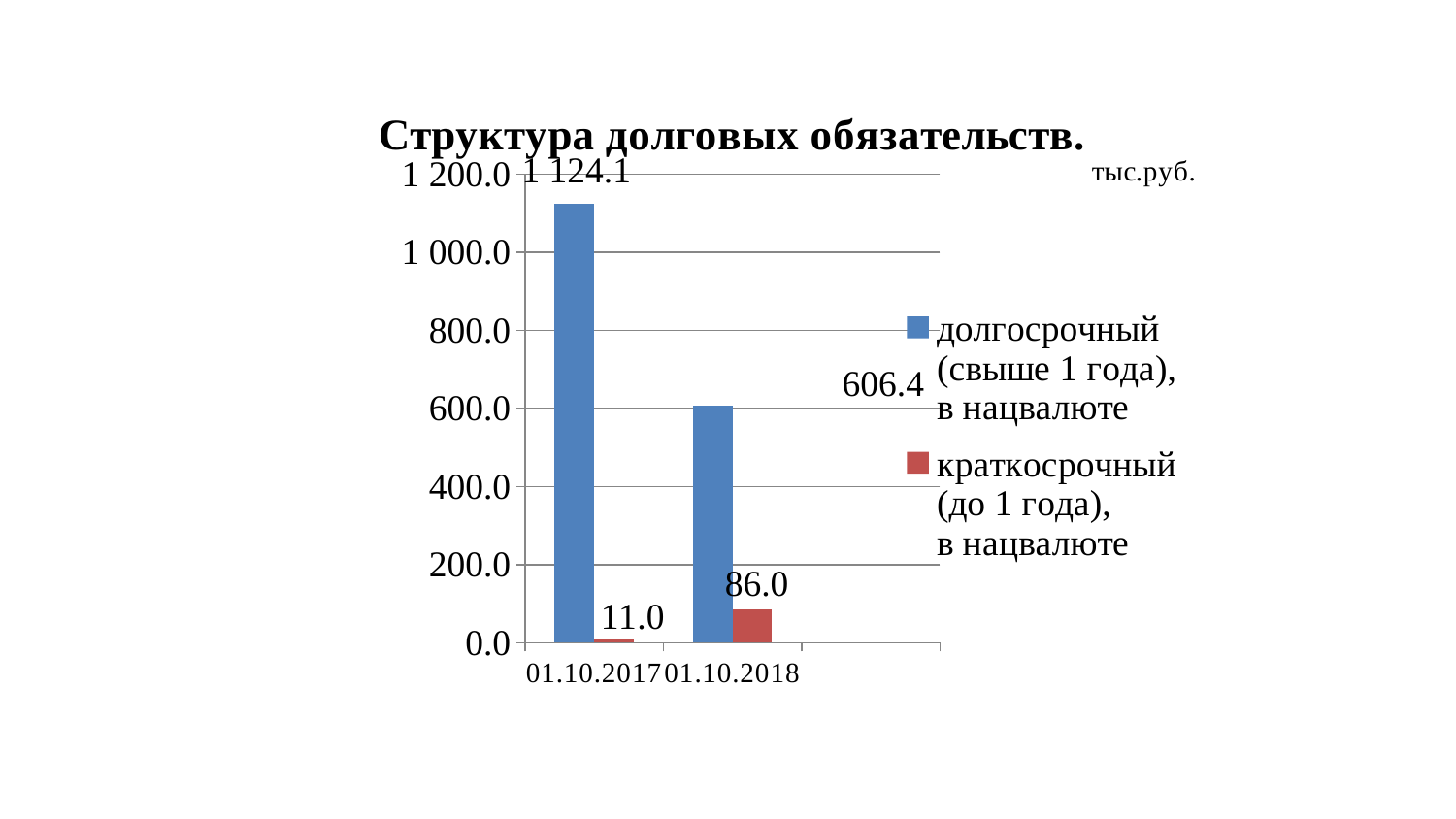
How many dates (categories) are shown on the x axis? 2 By how much did the долгосрочный (свыше 1 года), в нацвалюте value decrease from 01.10.2017 to 01.10.2018? 517.7 What is the value of the краткосрочный (до 1 года), в нацвалюте series for 01.10.2018? 86.0 What type of chart is shown on the slide? bar chart What is the value of the краткосрочный (до 1 года), в нацвалюте series for 01.10.2017? 11.0 Which date has the higher value for the долгосрочный (свыше 1 года), в нацвалюте series? 01.10.2017 What is the difference between the краткосрочный (до 1 года), в нацвалюте values for 01.10.2018 and 01.10.2017? 75.0 How many series does the legend list? 2 What is the value of the долгосрочный (свыше 1 года), в нацвалюте series for 01.10.2017? 1 124.1 What is the value of the долгосрочный (свыше 1 года), в нацвалюте series for 01.10.2018? 606.4 Which date has the lower value for the краткосрочный (до 1 года), в нацвалюте series? 01.10.2017 Is the краткосрочный (до 1 года), в нацвалюте value for 01.10.2018 larger or smaller than the value for 01.10.2017? larger